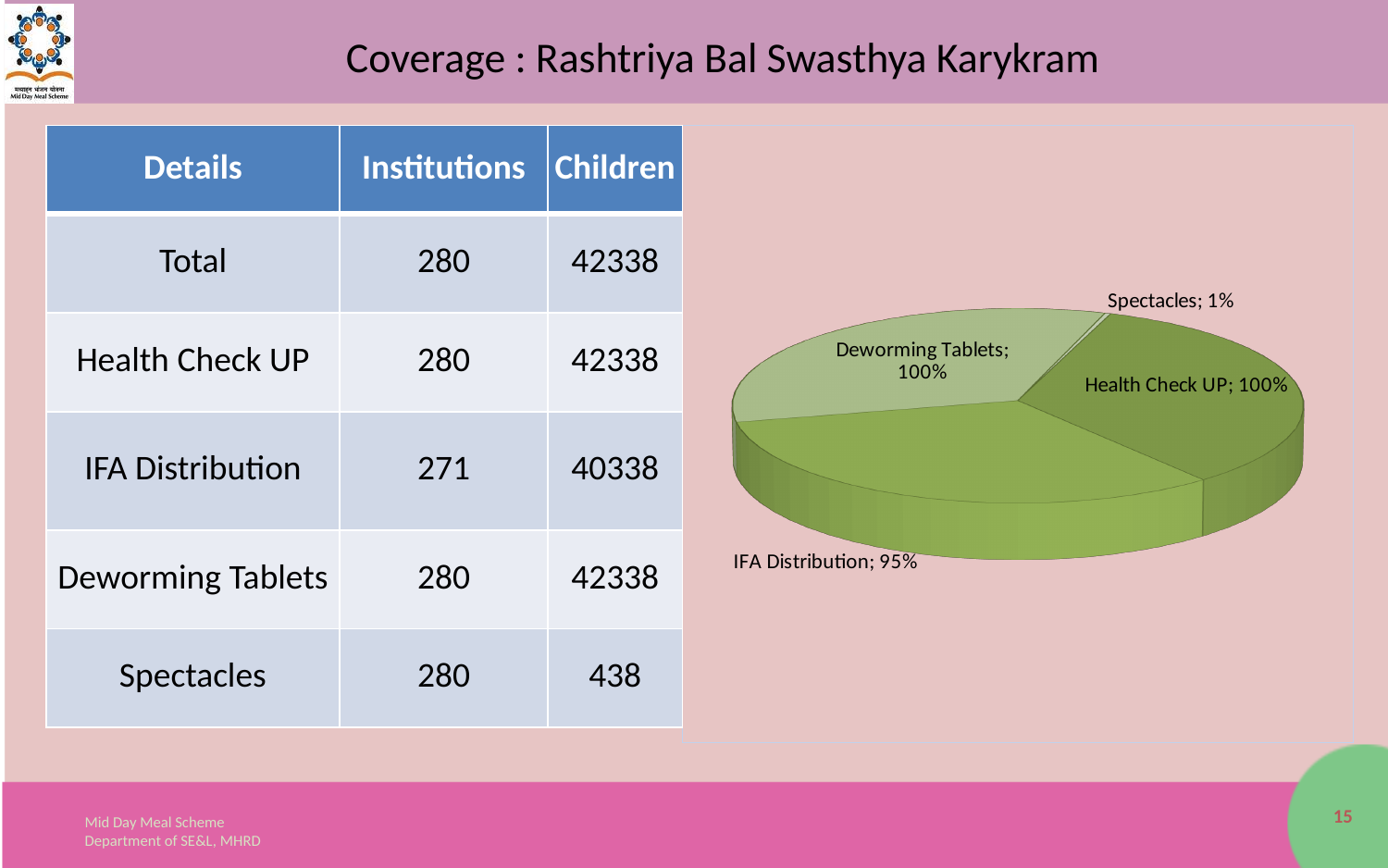
What value is labelled for IFA Distribution in the pie chart? 95% Which slice of the pie chart has the smallest labelled value? Spectacles What value is labelled for Spectacles in the pie chart? 1% How many slices does the pie chart have? 4 What kind of chart is shown on the slide? pie chart What is the title of the slide containing the pie chart? Coverage : Rashtriya Bal Swasthya Karykram Which is larger in the pie chart, the value for IFA Distribution or the value for Spectacles? IFA Distribution What value is labelled for Deworming Tablets in the pie chart? 100% What is the difference between the labelled values for Health Check UP and IFA Distribution in the pie chart? 5% Which two slices of the pie chart share the same labelled value of 100%? Deworming Tablets and Health Check UP What value is labelled for Health Check UP in the pie chart? 100% What is the difference between the labelled values for IFA Distribution and Spectacles in the pie chart? 94%